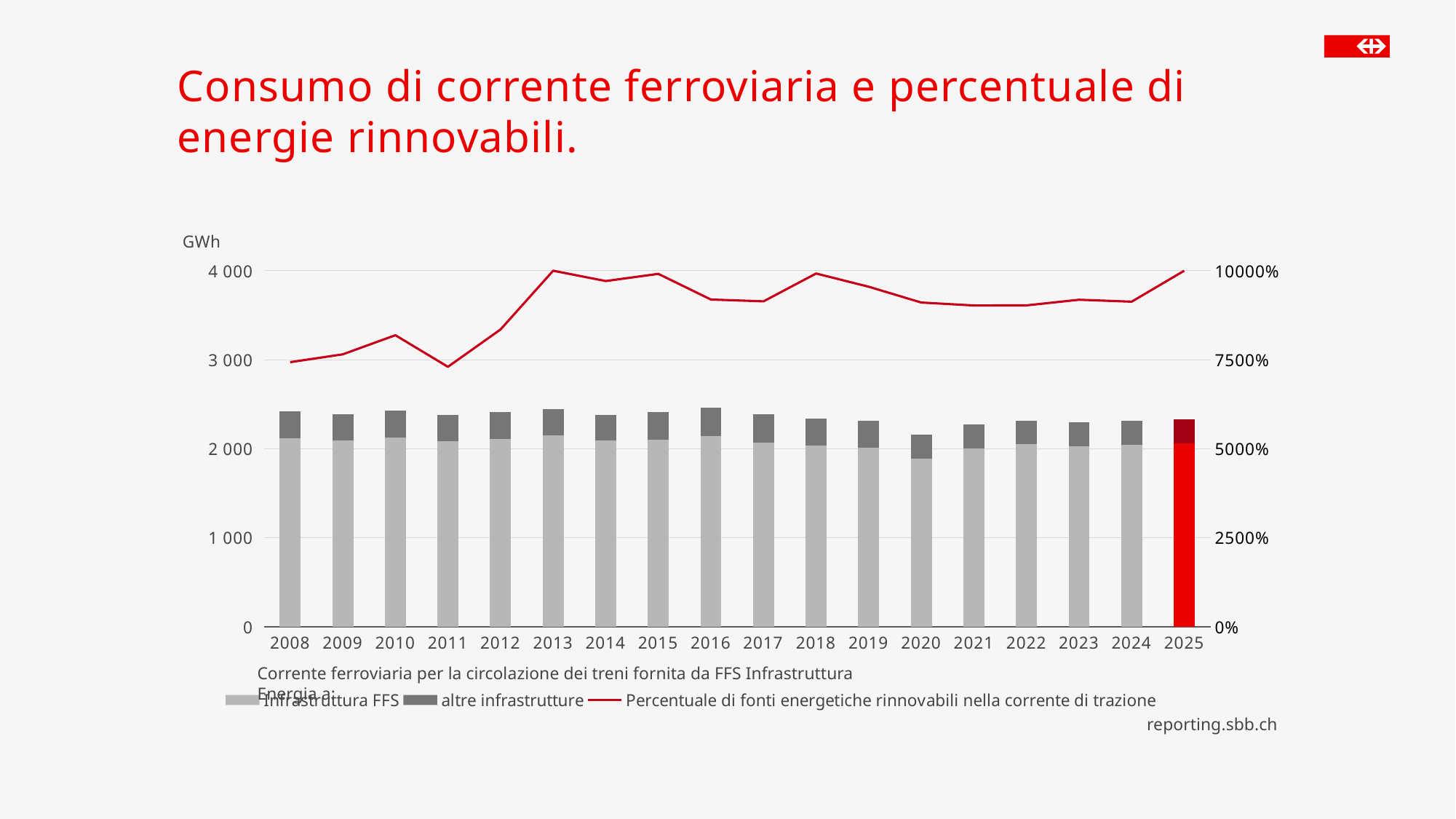
Which year has the higher value on the red line, 2011 or 2013? 2013 How many series does the legend list? 3 Is the total bar for 2016 greater or less than 3 000 GWh? less Is the value of the red line for 2020 greater or less than 10000%? less Which year has the lowest total bar (rail current consumption)? 2020 Is the total bar for 2020 greater or less than 2 000 GWh? greater Which year has the larger total bar, 2016 or 2020? 2016 What kind of chart is shown on the slide? A combined bar and line chart (stacked bars with a line) What is the unit shown on the left vertical axis? GWh How many years are shown on the x axis of the chart? 18 Does the red line rise or fall between 2011 and 2013? rises